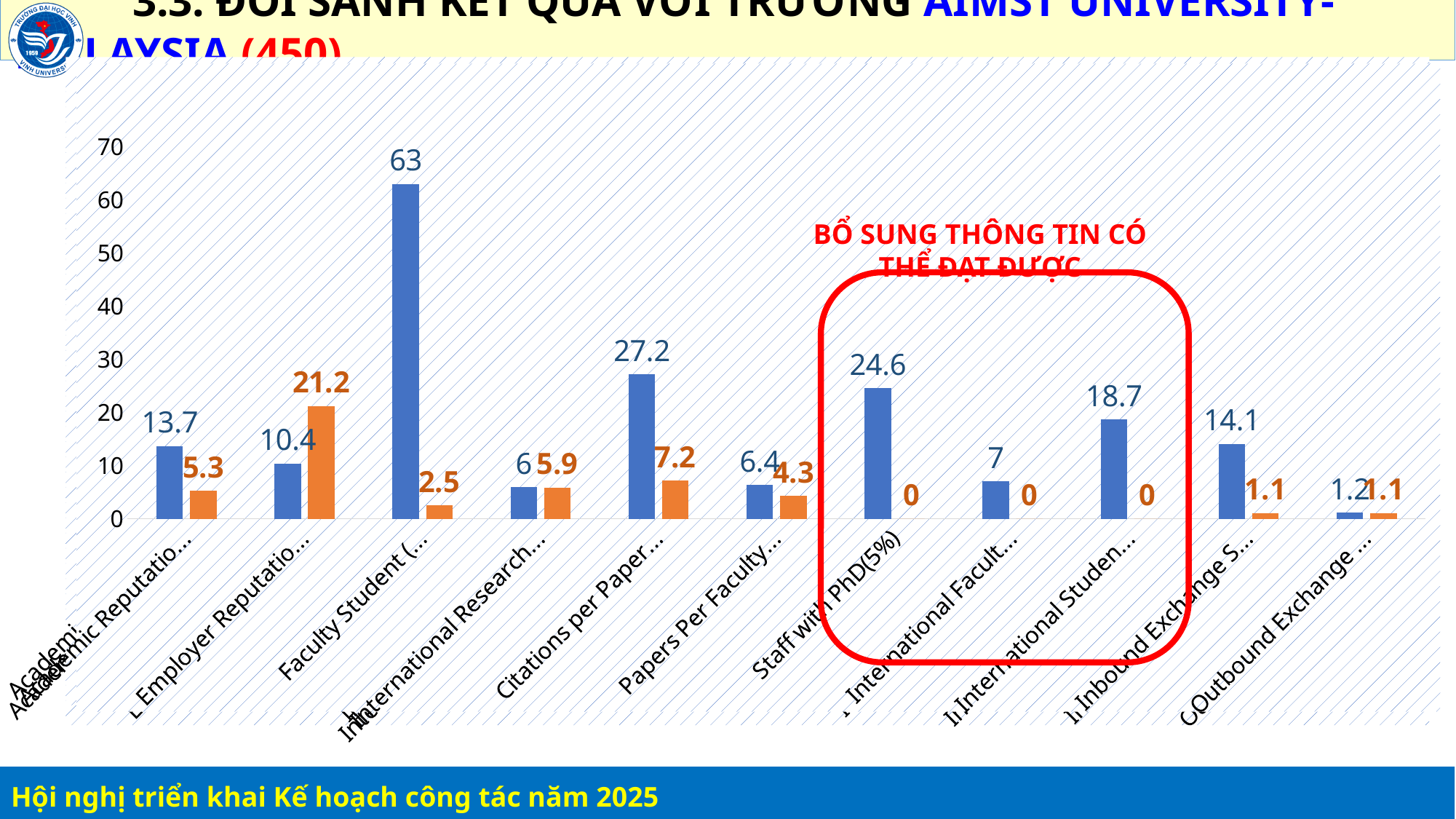
How many categories are shown on the x axis? 11 What is the difference between the blue bars for Papers Per Faculty and Citations per Paper? 20.8 Which is larger for Employer Reputation, the blue bar or the orange bar? the orange bar Which category has the highest orange bar? Employer Reputation Which category has the highest blue bar? Faculty Student What is the value of the orange bar for International Faculty? 0 What is the difference between the blue and orange bars for Academic Reputation? 8.4 What is the value of the orange bar for Employer Reputation? 21.2 What is the value of the orange bar for Citations per Paper? 7.2 What is the value of the blue bar for Staff with PhD(5%)? 24.6 What is the value of the blue bar for Faculty Student? 63 What type of chart is shown on the slide? bar chart